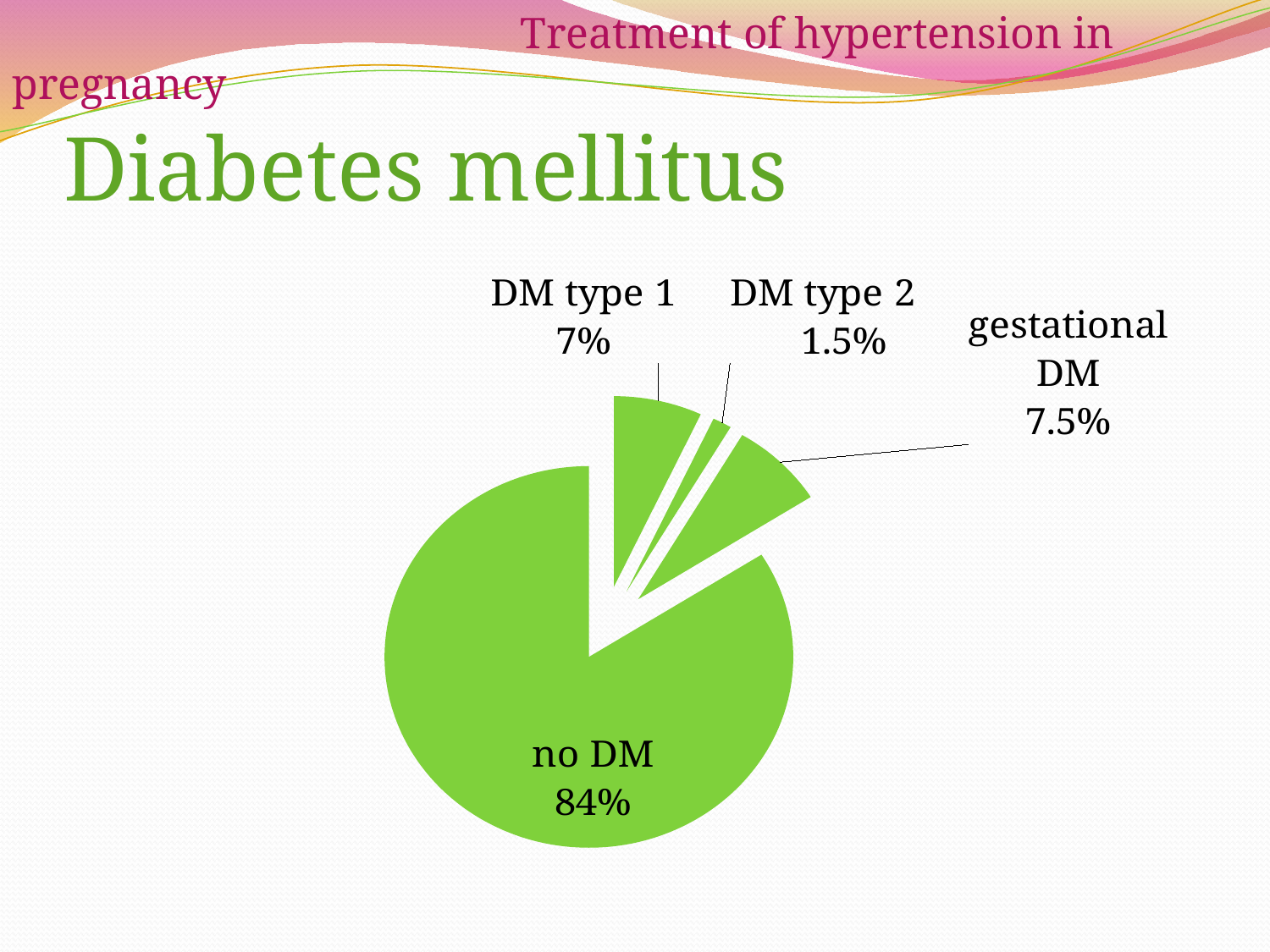
What percentage of the pie is labelled "no DM"? 84% What is the value shown for gestational DM? 7.5% What is the title of the chart on the slide? Diabetes mellitus What is the difference between the no DM share and the DM type 1 share? 77% What is the value shown for DM type 2? 1.5% What is the value shown for DM type 1? 7% What kind of chart is shown on the slide? pie chart Which is larger, the slice for gestational DM or the slice for DM type 1? gestational DM What is the difference between the gestational DM share and the DM type 2 share? 6% How many slices does the pie chart have? 4 Which slice of the pie is the largest? no DM Which slice of the pie is the smallest? DM type 2